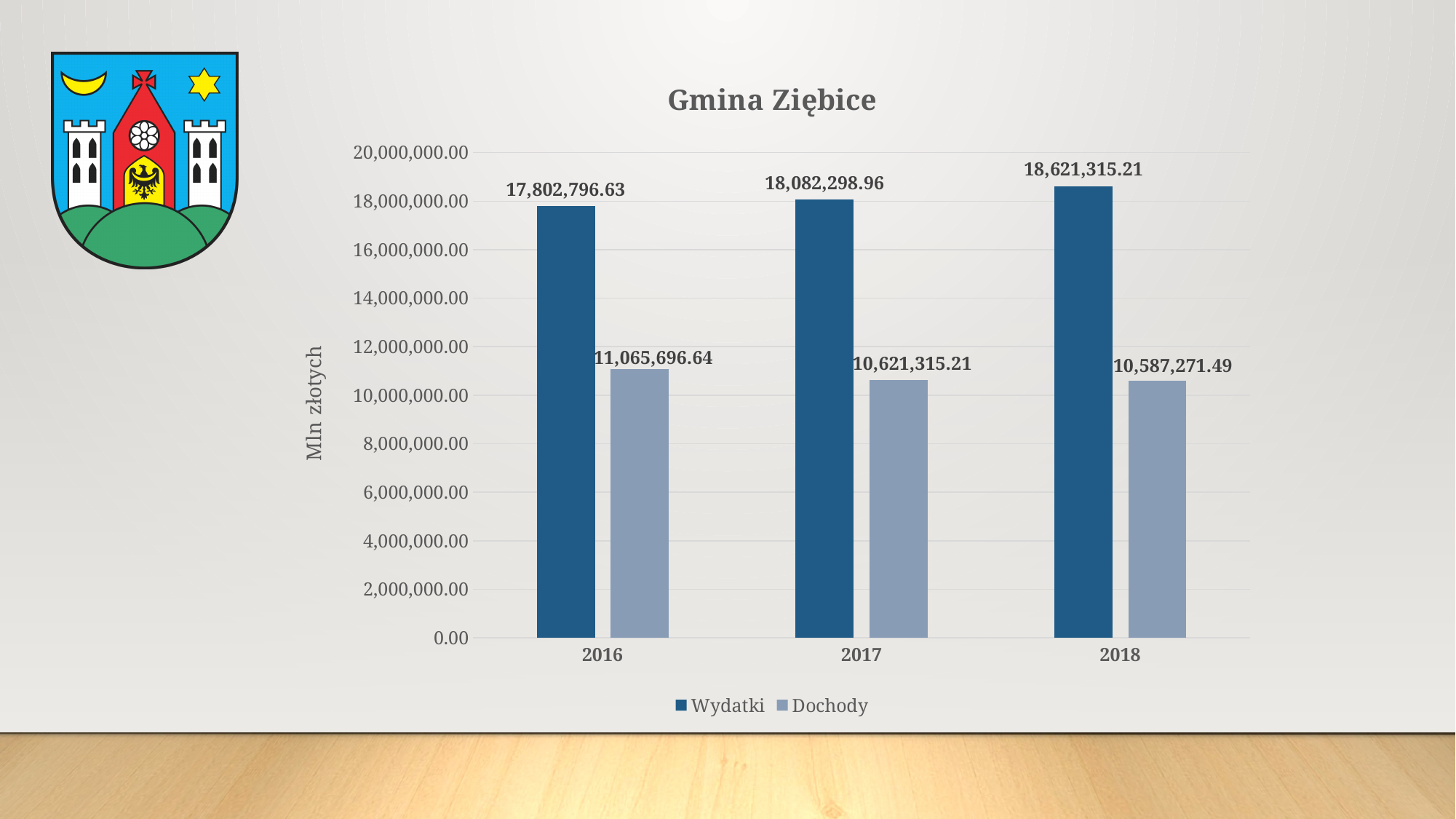
In which year is Wydatki highest? 2018 By how much did Wydatki increase from 2016 to 2018? 818,518.58 What kind of chart is shown? Bar chart What is the value of Wydatki for 2017? 18,082,298.96 Does Dochody rise or fall from 2016 to 2018? Fall What is the difference between Wydatki and Dochody in 2016? 6,737,099.99 What is the value of Dochody for 2018? 10,587,271.49 In which year is Dochody lowest? 2018 How many series does the legend list? 2 Which is larger in 2017, Wydatki or Dochody? Wydatki How many years are shown on the x axis? 3 What is the value of Wydatki for 2016? 17,802,796.63